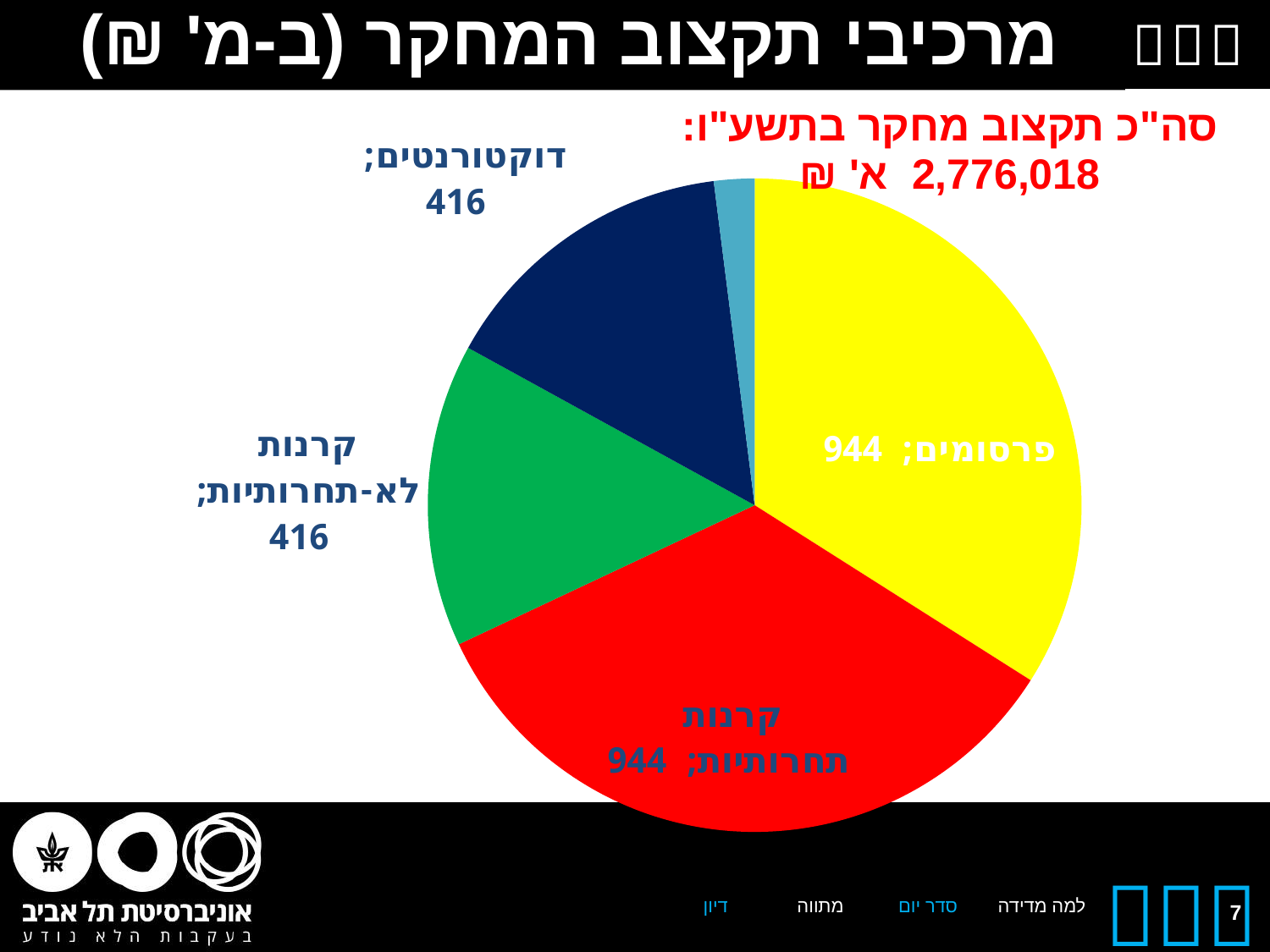
How many slices does the pie chart have? 5 What is the difference between the value for פרסומים and the value for דוקטורנטים? 528 What value is shown for the דוקטורנטים slice? 416 What value is shown for the פרסומים slice of the pie chart? 944 What value is shown for the קרנות לא-תחרותיות slice? 416 What is the difference between the value for קרנות תחרותיות and the value for קרנות לא-תחרותיות? 528 What total research budget for תשע"ו is stated in red text above the chart? 2,776,018 א' ₪ What colour is the פרסומים slice? Yellow Which has the larger value, קרנות תחרותיות or דוקטורנטים? קרנות תחרותיות What kind of chart is shown on the slide? Pie chart What value is shown for the קרנות תחרותיות slice? 944 Which has the larger value, פרסומים or קרנות לא-תחרותיות? פרסומים